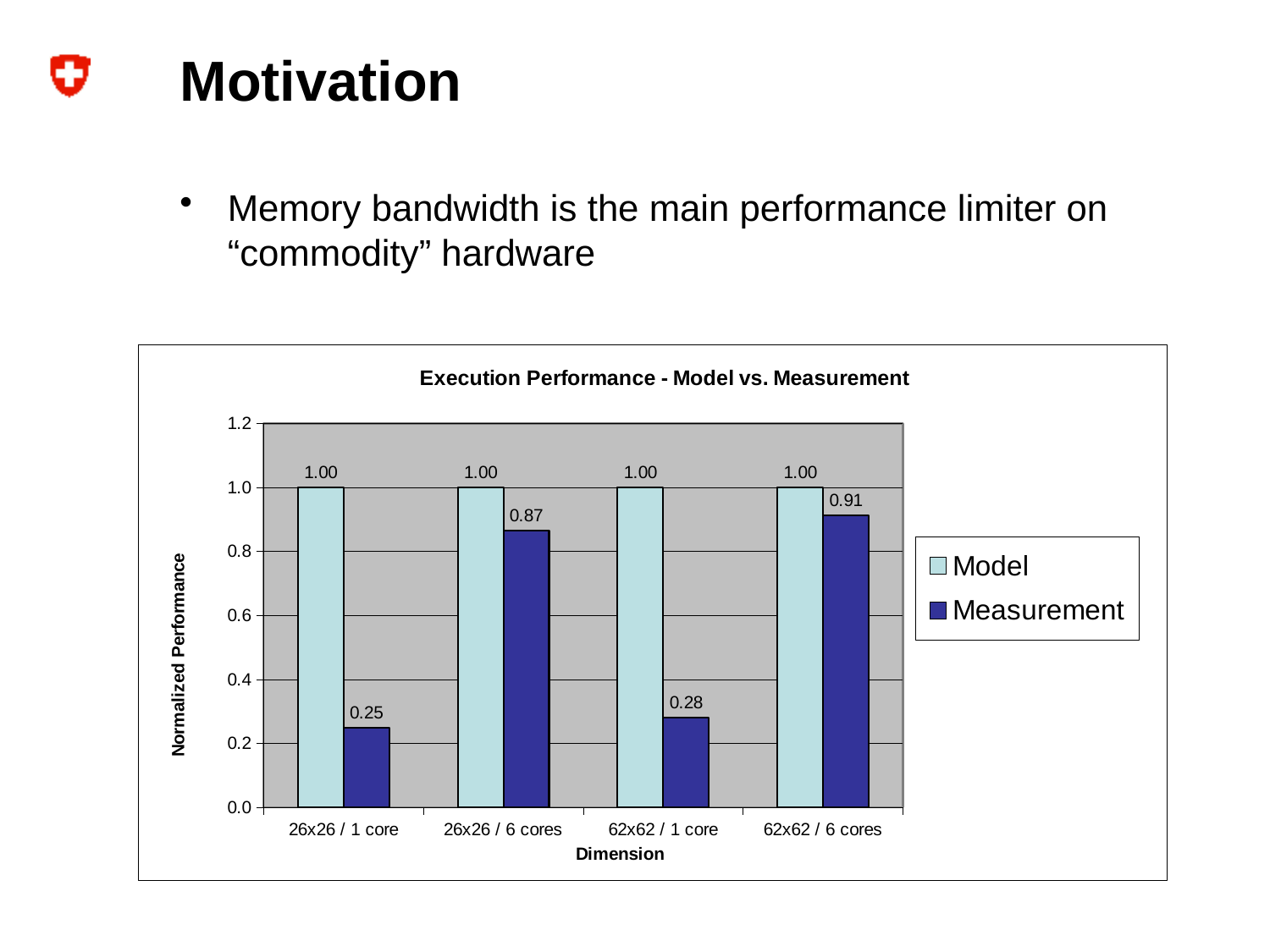
What is the Measurement value for 26x26 / 1 core? 0.25 How many categories are shown on the x axis? 4 Which category has the highest Measurement value? 62x62 / 6 cores What is the Measurement value for 62x62 / 6 cores? 0.91 What is the difference between the Model and Measurement values for 26x26 / 6 cores? 0.13 What is the title of the chart? Execution Performance - Model vs. Measurement Is the Measurement value for 62x62 / 1 core greater or less than 0.4? less Which is larger, the Measurement value for 62x62 / 1 core or for 26x26 / 1 core? 62x62 / 1 core What is the Model value for 26x26 / 6 cores? 1.00 How many series does the legend list? 2 What kind of chart is shown? bar chart Which category has the lowest Measurement value? 26x26 / 1 core